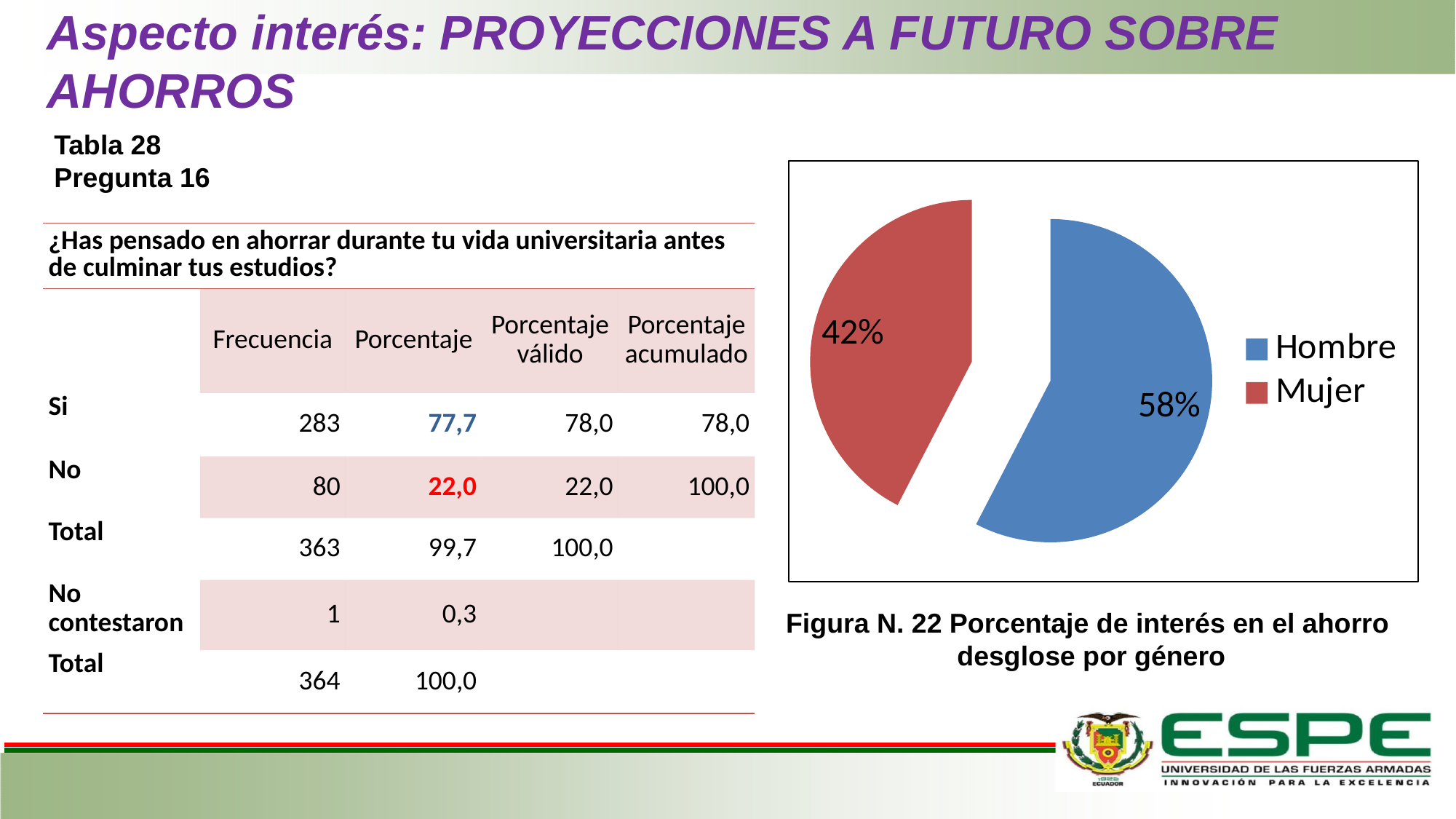
What kind of chart is shown on the slide? pie chart Which slice is larger, Hombre or Mujer? Hombre What is the caption of the figure below the pie chart? Figura N. 22 Porcentaje de interés en el ahorro desglose por género Which category has the smallest share of the pie chart? Mujer What percentage of the pie chart corresponds to Hombre? 58% What colour is the Mujer slice in the pie chart? red Which category has the largest share of the pie chart? Hombre What is the difference in percentage points between the Hombre and Mujer slices? 16% How many entries does the legend of the pie chart list? 2 How many slices does the pie chart have? 2 What percentage of the pie chart corresponds to Mujer? 42%